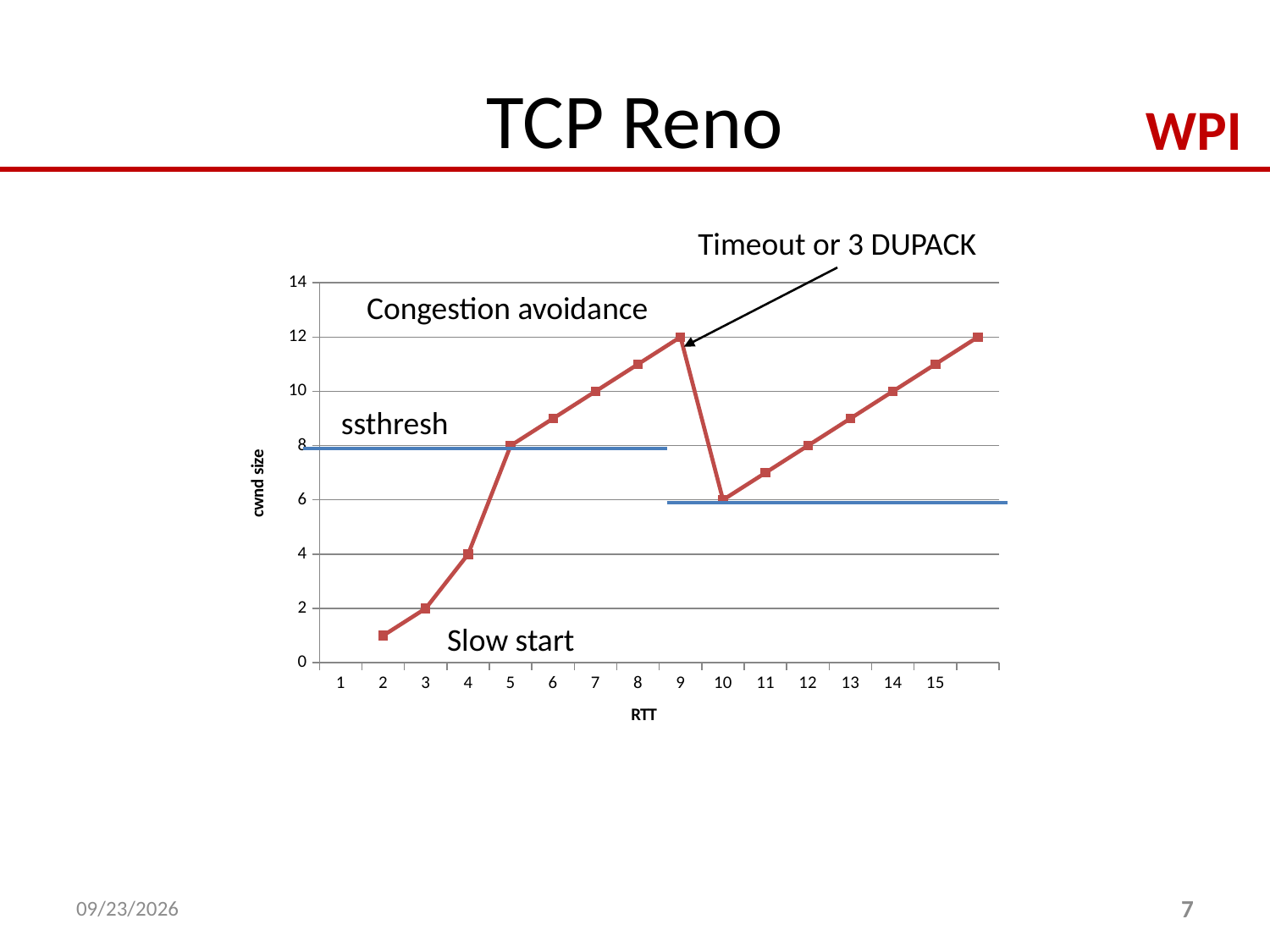
What is the cwnd size at RTT 9? 12 What kind of chart is shown on the slide? line chart Is the cwnd size at RTT 8 greater or less than 10? greater What is the cwnd size at RTT 10? 6 What is the label on the y axis of the chart? cwnd size Does the cwnd size rise or fall from RTT 2 to RTT 9? rise What is the cwnd size at RTT 14? 10 Which has a larger cwnd size, RTT 5 or RTT 10? RTT 5 By how much does the cwnd size drop from RTT 9 to RTT 10? 6 What is the cwnd size at RTT 5? 8 What is the cwnd size at RTT 4? 4 At which RTT is the cwnd size lowest? 2